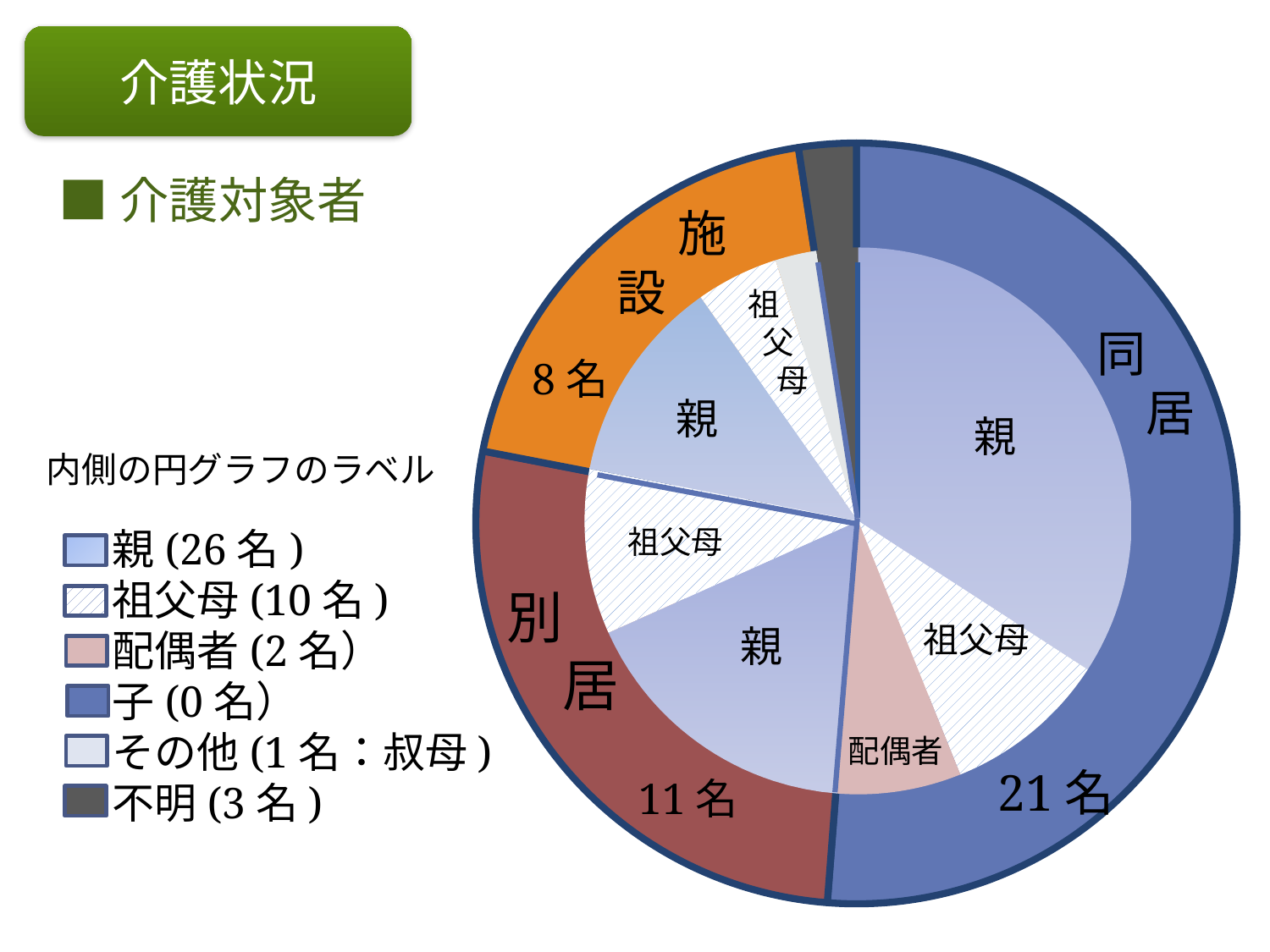
What is the difference between the number of 親 and the number of 祖父母 in the inner pie legend? 16名 How many entries does the legend for the inner pie list? 6 How many people are in the 別居 category on the outer ring? 11名 How many people are in the 同居 category on the outer ring? 21名 How many people are in the 施設 category on the outer ring? 8名 Which of the labelled outer-ring categories (同居, 別居, 施設) has the smallest number of people? 施設 What is the difference in the number of people between 同居 and 別居? 10名 According to the legend for the inner pie, how many people are in the 親 category? 26名 Which is larger, the number of people in 別居 or in 施設? 別居 Which of the labelled outer-ring categories (同居, 別居, 施設) has the largest number of people? 同居 What kind of chart is shown on the slide? pie chart According to the legend for the inner pie, how many people are in the 祖父母 category? 10名